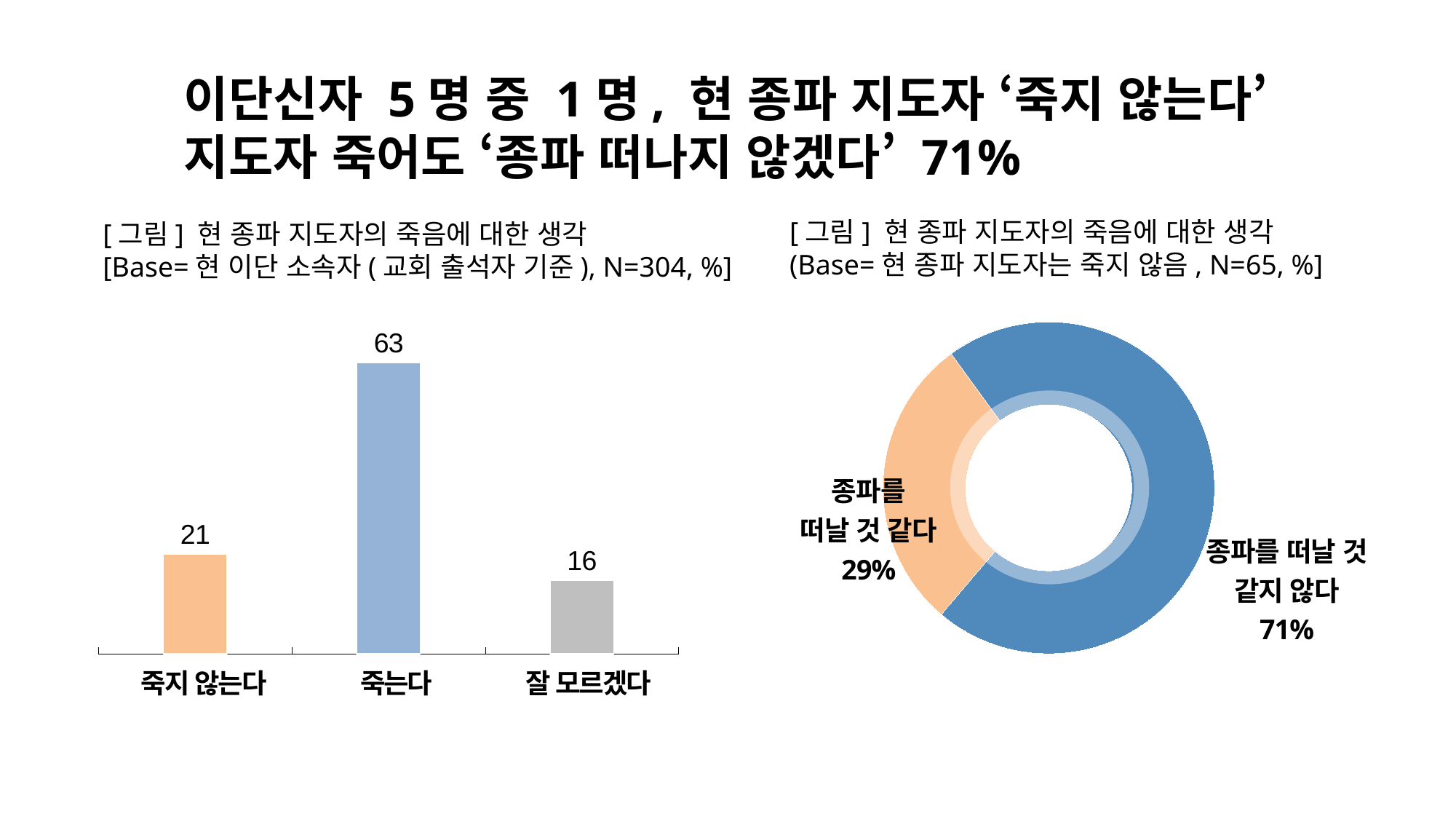
In the bar chart on the left, which category has the lowest value? 잘 모르겠다 In the bar chart on the left, what is the value for 죽는다? 63 In the doughnut chart on the right, what share is labelled 종파를 떠날 것 같지 않다? 71% What kind of chart is shown on the left of the slide? Bar chart In the bar chart on the left, which is larger: 죽지 않는다 or 잘 모르겠다? 죽지 않는다 In the bar chart on the left, which category has the highest value? 죽는다 In the doughnut chart on the right, what share is labelled 종파를 떠날 것 같다? 29% In the bar chart on the left, what is the difference between the values for 죽는다 and 죽지 않는다? 42 In the doughnut chart on the right, what is the base size (N) stated in the caption? N=65 In the bar chart on the left, what is the value for 잘 모르겠다? 16 How many categories does the bar chart on the left show? 3 In the bar chart on the left, what is the value for 죽지 않는다? 21